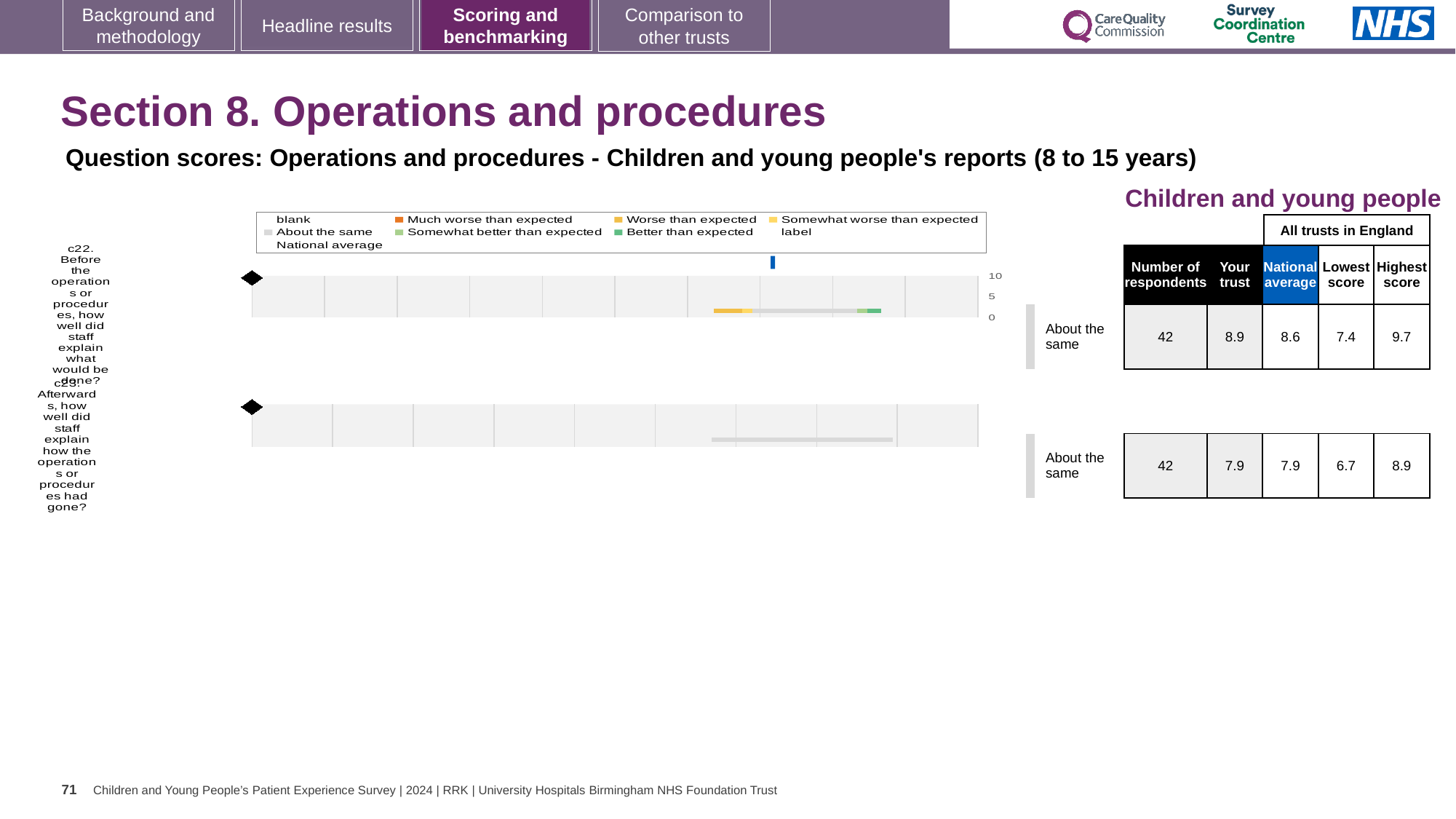
Which question has the higher 'Your trust' score, c22 or c23? c22 What is the highest score among all trusts in England for question c23? 8.9 How many respondents answered question c22? 42 By how much does the trust's score for c22 (8.9) exceed the national average (8.6)? 0.3 According to the table beside the chart, what is the 'Your trust' score for question c23 (Afterwards, how well did staff explain how the operations or procedures had gone?)? 7.9 What kind of chart is shown on the slide? bar chart What is the difference between the highest score (9.7) and the lowest score (7.4) for question c22? 2.3 What colour does the legend use for 'Better than expected'? green According to the table beside the chart, what is the 'Your trust' score for question c22 (Before the operations or procedures, how well did staff explain what would be done?)? 8.9 What benchmark category is shown for question c22? About the same How many survey questions are plotted in the chart? 2 According to the table beside the chart, what is the national average for question c22? 8.6